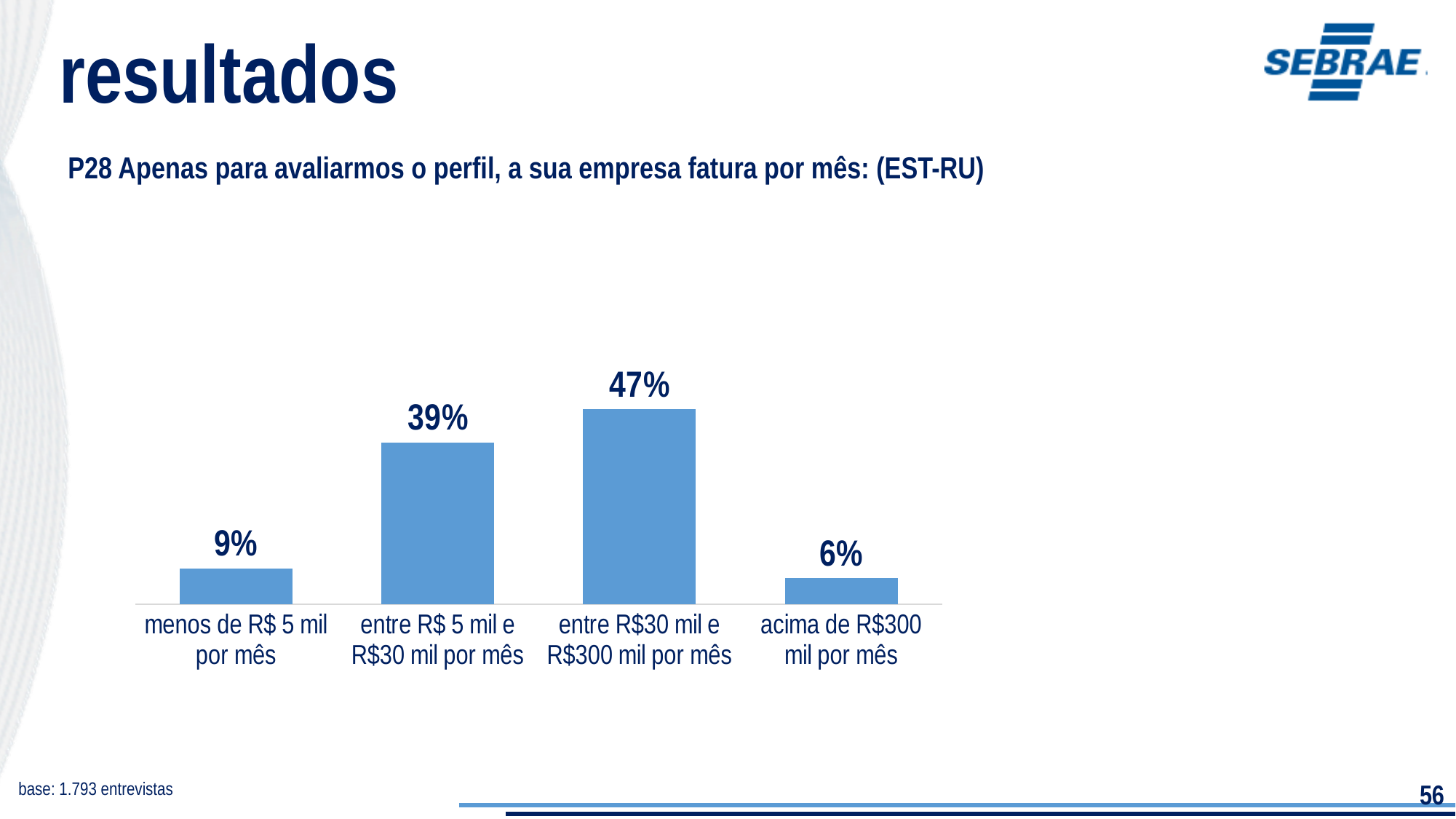
Which is larger: the value for 'menos de R$ 5 mil por mês' or the value for 'acima de R$300 mil por mês'? menos de R$ 5 mil por mês What is the base (number of interviews) stated for the chart? 1.793 entrevistas What is the value shown for 'entre R$30 mil e R$300 mil por mês'? 47% What is the difference in percentage points between 'entre R$30 mil e R$300 mil por mês' and 'entre R$ 5 mil e R$30 mil por mês'? 8 percentage points What percentage of companies report revenue 'acima de R$300 mil por mês'? 6% What percentage of companies report monthly revenue of 'menos de R$ 5 mil por mês'? 9% Which revenue category has the highest percentage? entre R$30 mil e R$300 mil por mês What type of chart is shown on the slide? Bar chart What is the value shown for 'entre R$ 5 mil e R$30 mil por mês'? 39% How many revenue categories are shown in the chart? 4 Which revenue category has the lowest percentage? acima de R$300 mil por mês What is the difference between the values for 'menos de R$ 5 mil por mês' and 'acima de R$300 mil por mês'? 3 percentage points